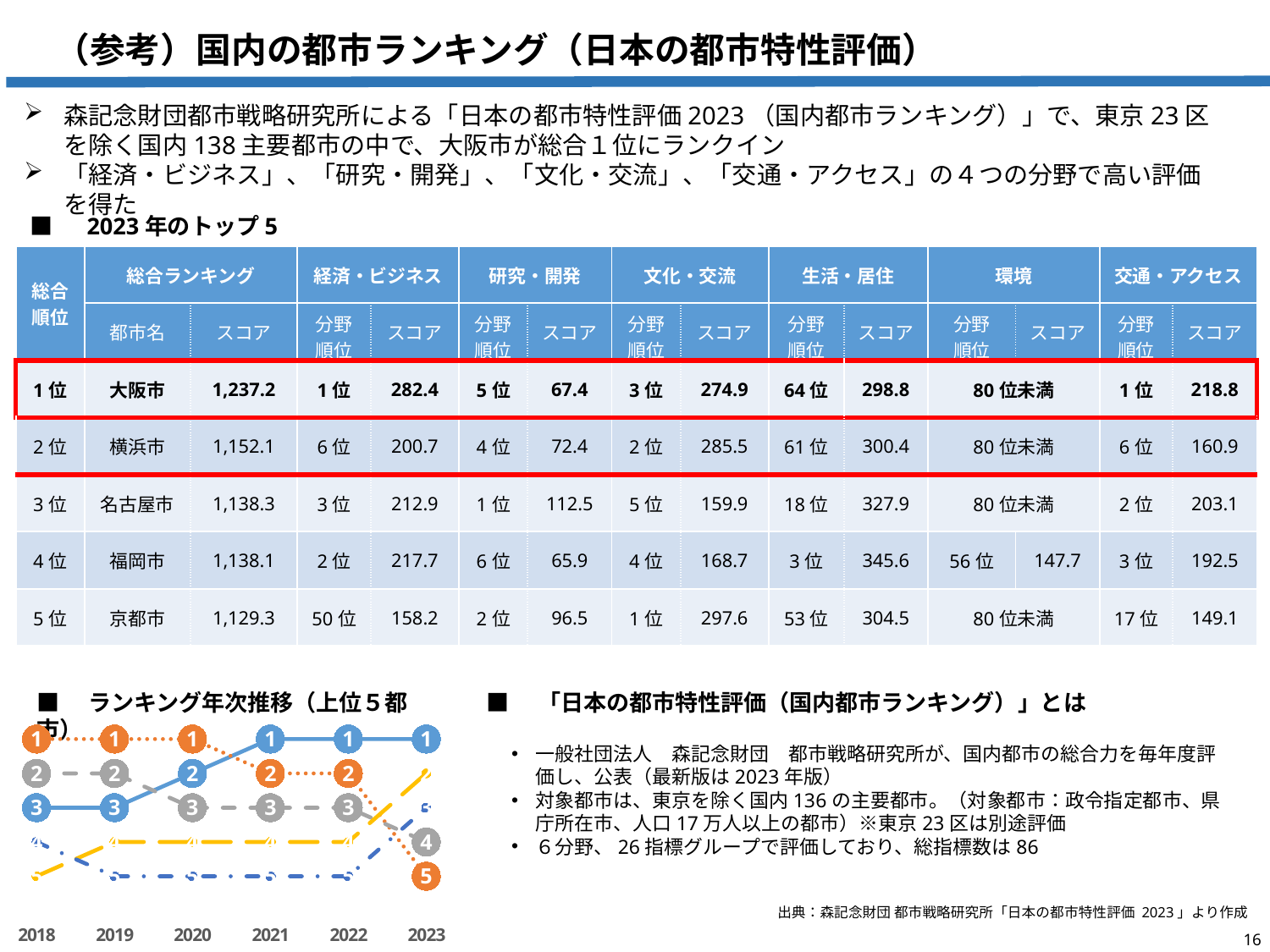
In the 「ランキング年次推移（上位5都市）」 chart, what is the first year shown on the x axis? 2018 What is the title of the line chart at the bottom left of the slide? ランキング年次推移（上位5都市） In the 「ランキング年次推移（上位5都市）」 chart, what is the last year shown on the x axis? 2023 In the 「ランキング年次推移（上位5都市）」 chart, how many years are shown on the x axis? 6 In the 「ランキング年次推移（上位5都市）」 chart, what is the highest rank number labelled for 2023? 1 What kind of chart is shown at the bottom left of the slide under 「ランキング年次推移（上位5都市）」? line chart In the 「ランキング年次推移（上位5都市）」 chart, what is the lowest rank number labelled for 2023? 5